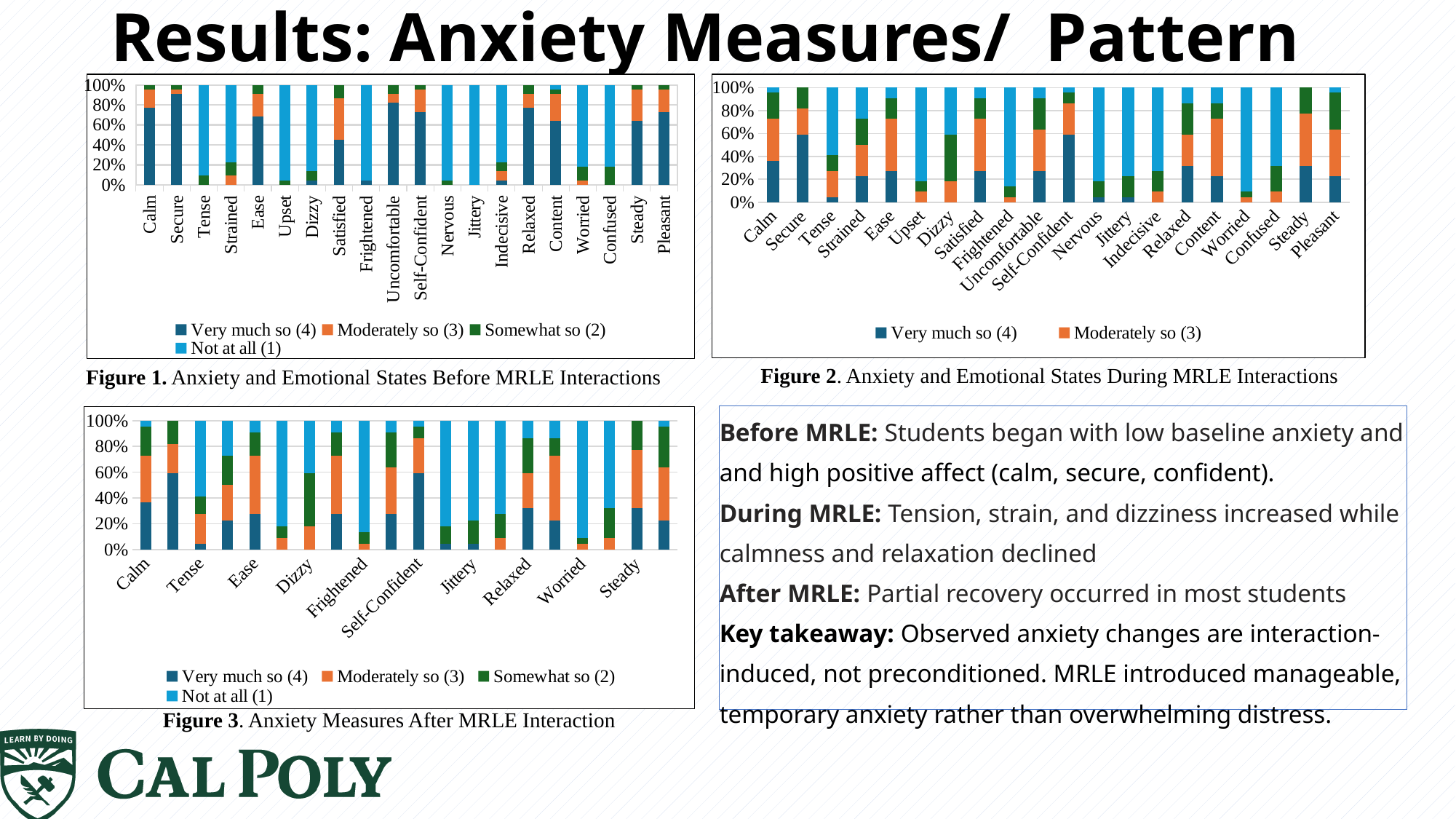
In Figure 1 (Before MRLE Interactions), is the 'Very much so (4)' share for Calm greater or less than 60%? greater What is the caption of the chart in the top-left of the slide? Figure 1. Anxiety and Emotional States Before MRLE Interactions In Figure 2 (During MRLE Interactions), how many series does the legend list? 2 In Figure 2 (During MRLE Interactions), is the 'Very much so (4)' share for Tense greater or less than 20%? less In Figure 1 (Before MRLE Interactions), how many series does the legend list? 4 In Figure 3 (After MRLE Interaction), is the 'Very much so (4)' share for Calm greater or less than 20%? greater In Figure 1 (Before MRLE Interactions), which has the larger 'Very much so (4)' share, Secure or Tense? Secure In Figure 1 (Before MRLE Interactions), how many categories are shown on the x axis? 20 What kind of chart is Figure 1 (Anxiety and Emotional States Before MRLE Interactions)? Stacked bar chart In Figure 2 (During MRLE Interactions), which has the larger 'Very much so (4)' share, Calm or Tense? Calm In Figure 3 (After MRLE Interaction), which legend entry is shown in light blue? Not at all (1)